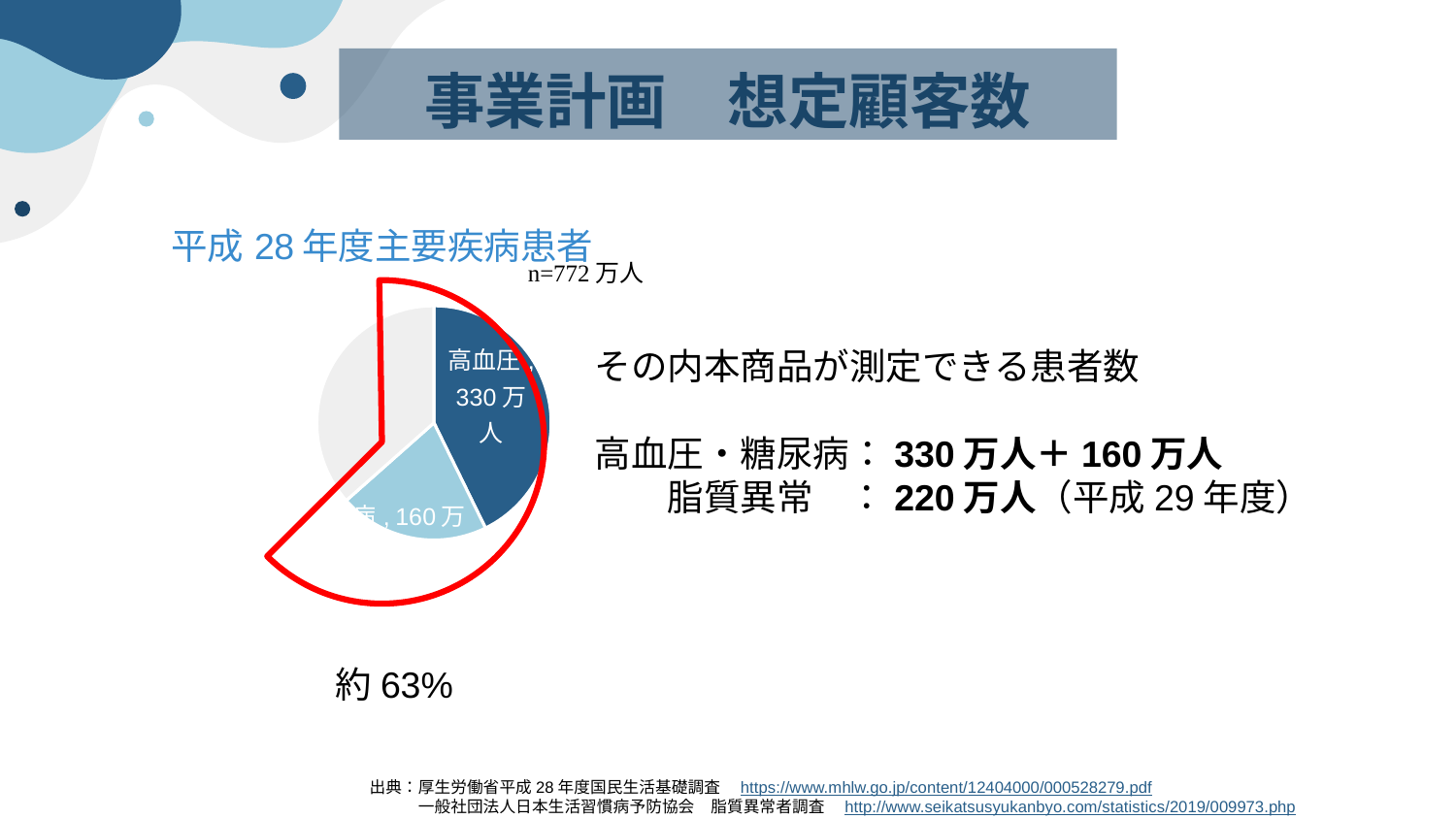
What is the title of the pie chart? 平成28年度主要疾病患者 What is the n value shown above the pie chart? n=772万人 What is the difference between the 高血圧 slice (330万) and the light blue slice (160万)? 170万 What percentage is shown for the portion of the pie outlined in red? 約63% How many slices does the pie chart have? 3 Which is larger in the pie chart, the 高血圧 slice or the light blue slice labelled 160万? 高血圧 What is the value shown for 高血圧 in the pie chart? 330万人 Does the 高血圧 slice take up more or less than half of the pie? less What is the combined value of the 高血圧 slice (330万) and the light blue slice (160万)? 490万 What kind of chart is shown on the slide? pie chart What value is printed on the light blue slice of the pie chart? 160万